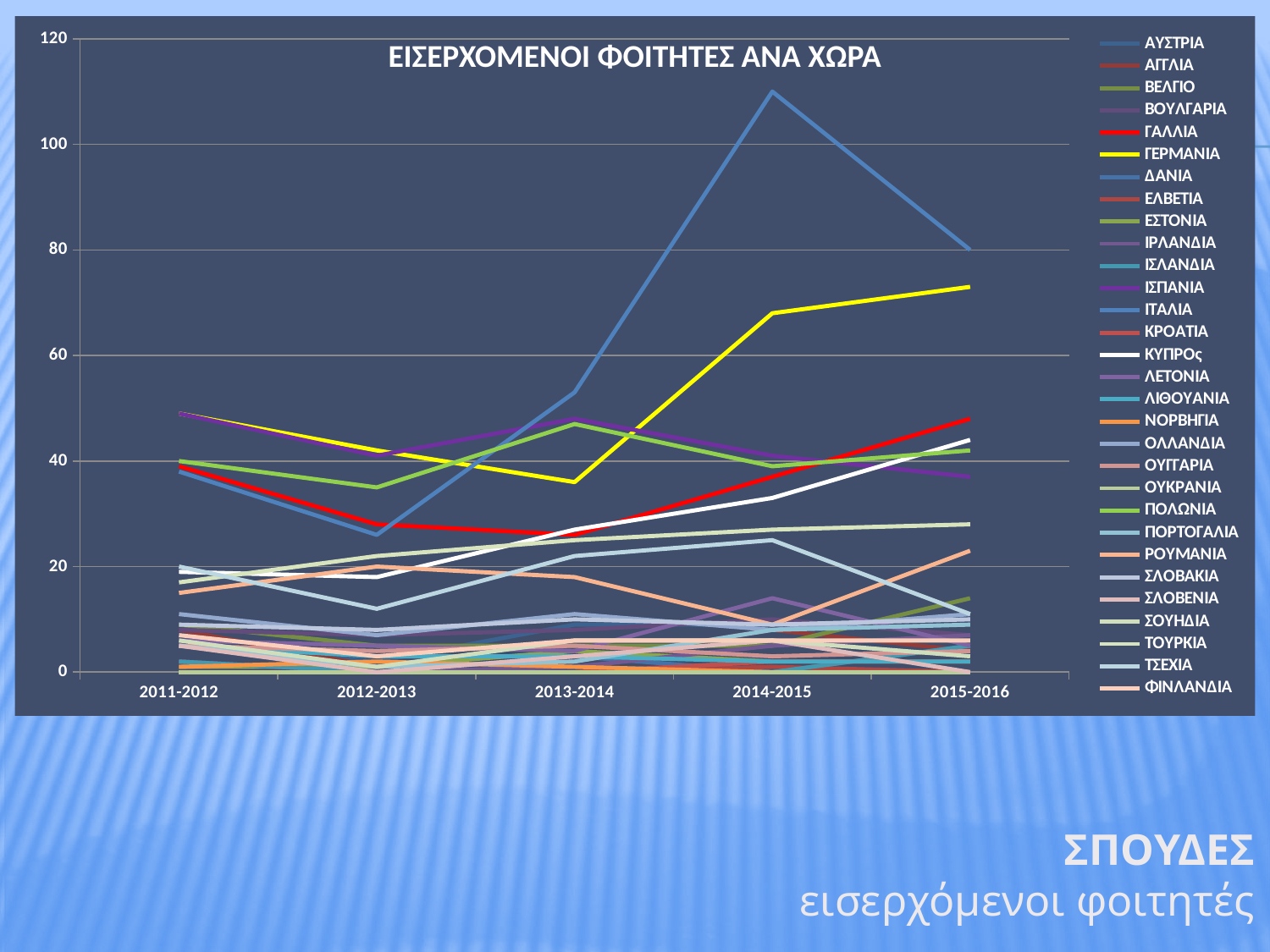
What kind of chart is shown on the slide? line chart What is the title of the chart? ΕΙΣΕΡΧΟΜΕΝΟΙ ΦΟΙΤΗΤΕΣ ΑΝΑ ΧΩΡΑ In 2015-2016, which is larger, the value for ΓΕΡΜΑΝΙΑ or the value for ΓΑΛΛΙΑ? ΓΕΡΜΑΝΙΑ Is the value for ΓΑΛΛΙΑ in 2013-2014 greater or less than 40? less How many academic years are shown on the x axis? 5 Does the value for ΚΥΠΡΟς rise or fall from 2012-2013 to 2015-2016? rise Is the value for ΙΣΠΑΝΙΑ in 2011-2012 greater or less than 40? greater How many series does the legend list? 30 Is the value for ΓΕΡΜΑΝΙΑ in 2013-2014 greater or less than 40? less In which academic year does the highest value on the chart occur? 2014-2015